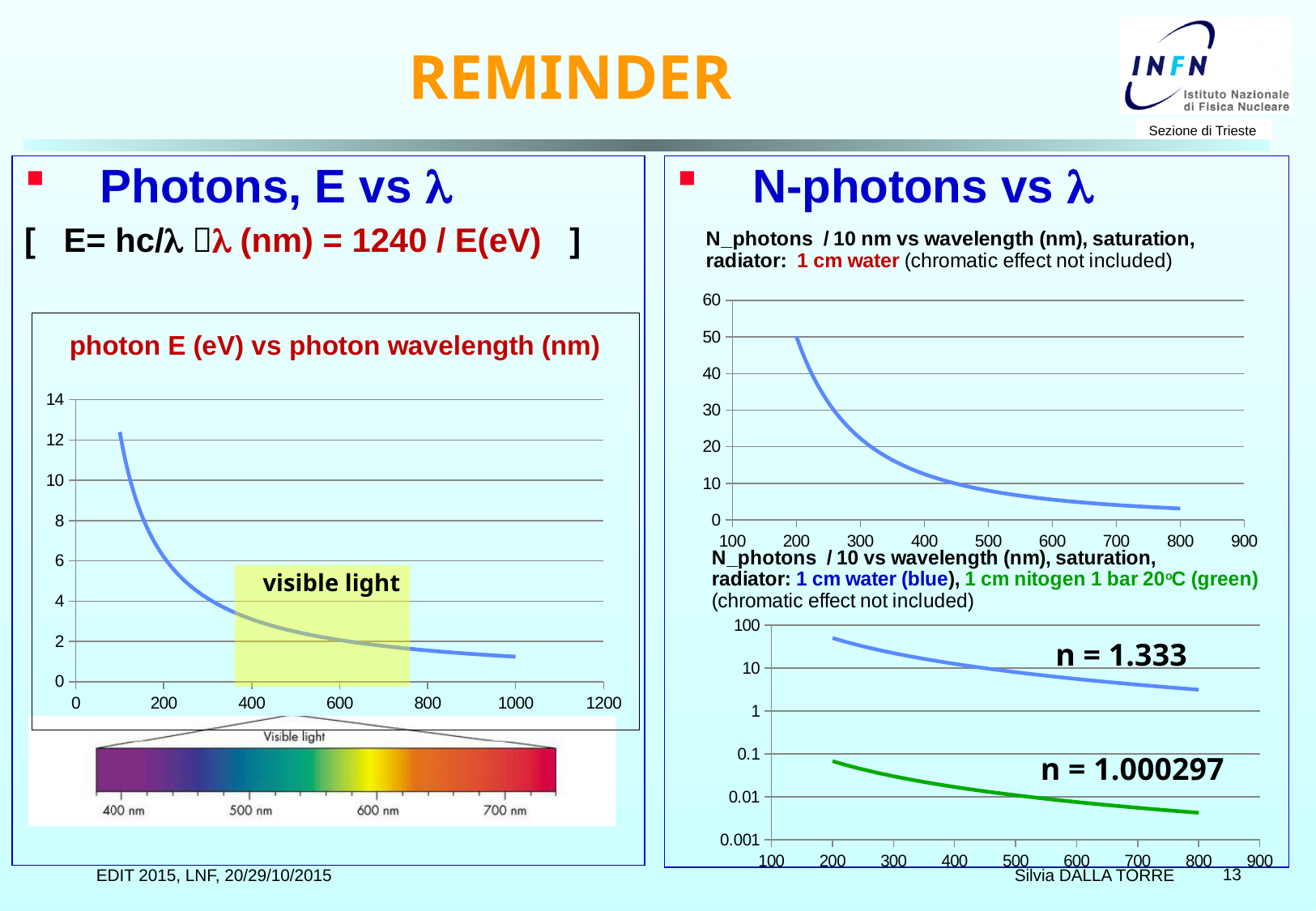
In the left chart 'photon E (eV) vs photon wavelength (nm)', is the value at 200 nm greater or less than 4? greater In the left chart 'photon E (eV) vs photon wavelength (nm)', what label is written in the yellow shaded region? visible light In the top-right chart 'N_photons / 10 nm vs wavelength (nm)', is the value at 200 nm greater or less than 40? greater In the bottom-right chart 'N_photons / 10 vs wavelength (nm)', is the green (n = 1.000297) value at 800 nm greater or less than 0.01? less How many series are plotted in the bottom-right chart 'N_photons / 10 vs wavelength (nm)' with water and nitrogen radiators? 2 In the bottom-right chart 'N_photons / 10 vs wavelength (nm)', which series is higher, the blue (n = 1.333) or the green (n = 1.000297)? blue (n = 1.333) What kind of chart is the left chart titled 'photon E (eV) vs photon wavelength (nm)'? line chart In the top-right chart 'N_photons / 10 nm vs wavelength (nm)', what radiator is named in the chart title? 1 cm water In the left chart 'photon E (eV) vs photon wavelength (nm)', does the photon energy rise or fall as wavelength increases? fall In the top-right chart 'N_photons / 10 nm vs wavelength (nm)', does the number of photons rise or fall as wavelength increases? fall